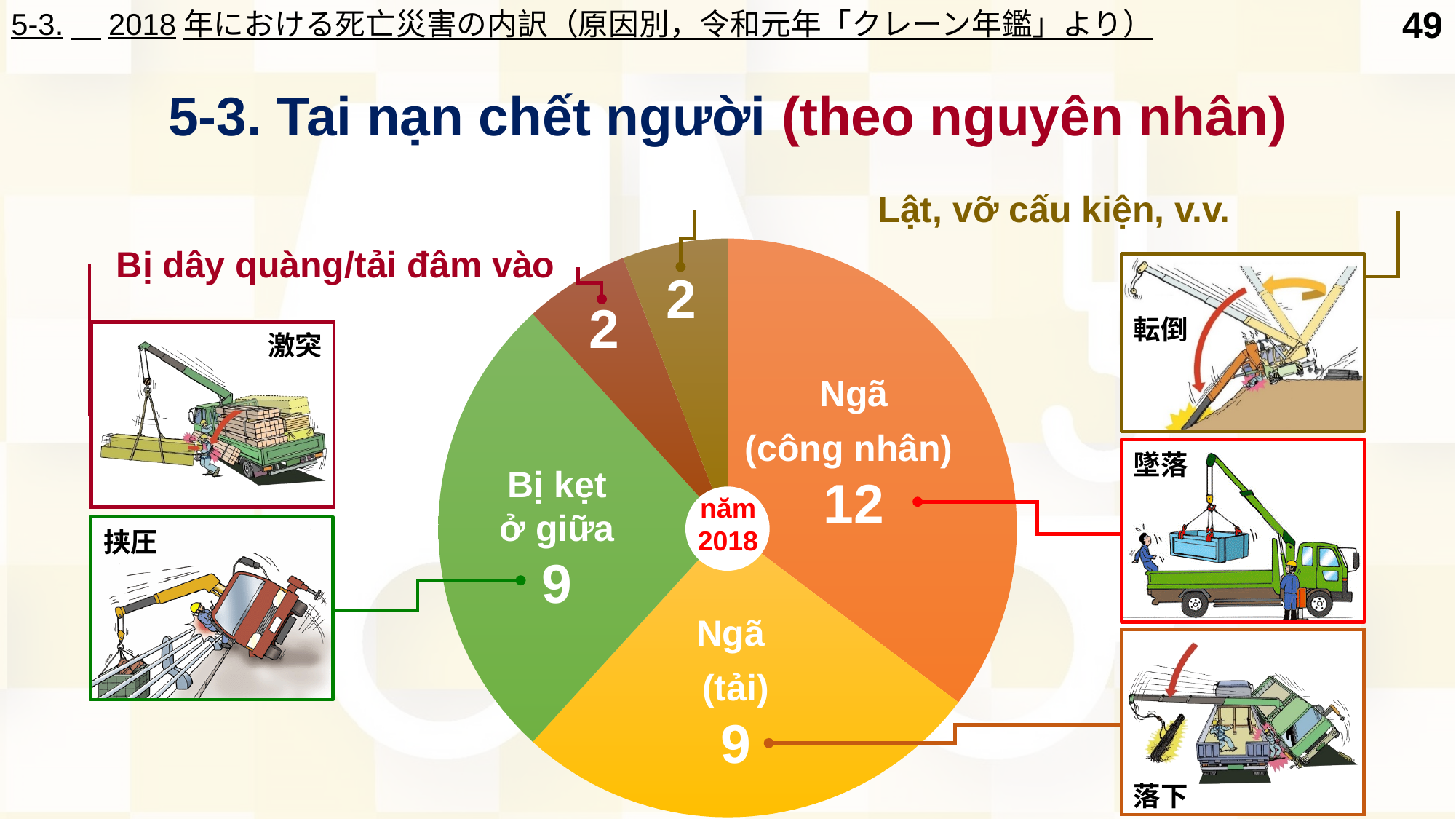
What is the value for Bị kẹt ở giữa? 9 What is the value for Lật, vỡ cấu kiện, v.v.? 2 What is the value for Ngã (tải)? 9 Which category has the largest slice of the pie? Ngã (công nhân) What is the value for Ngã (công nhân)? 12 What kind of chart is shown on the slide? pie chart Which is larger, the value for Bị kẹt ở giữa or the value for Bị dây quàng/tải đâm vào? Bị kẹt ở giữa What year is written in the centre of the pie chart? năm 2018 What is the value for Bị dây quàng/tải đâm vào? 2 What is the total of all the values shown in the pie chart? 34 What is the difference between the values for Ngã (công nhân) and Ngã (tải)? 3 How many slices does the pie chart have? 5